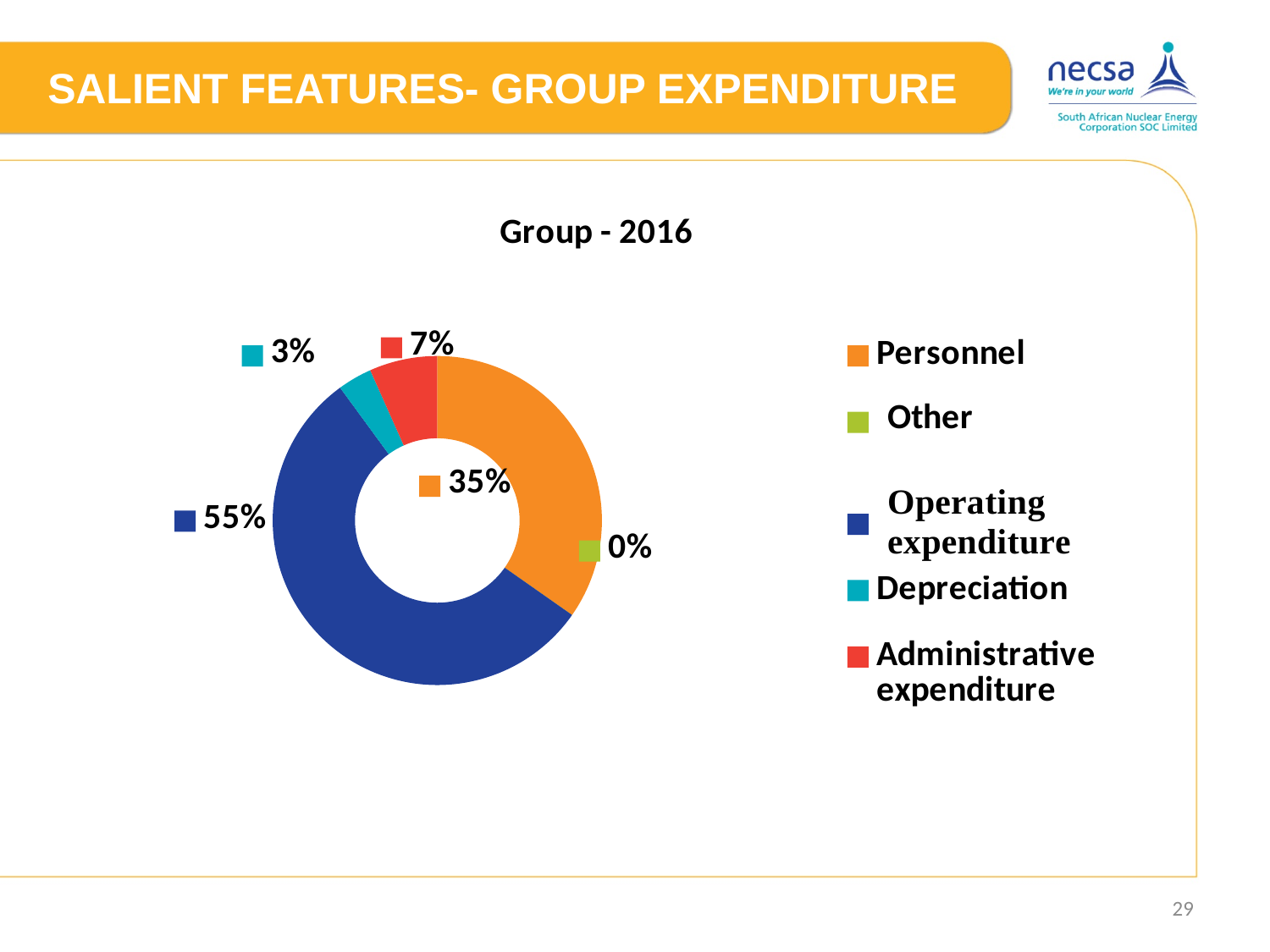
How many categories does the legend list? 5 What is the difference in percentage points between Operating expenditure and Personnel? 20 percentage points What share of Group expenditure in 2016 is Administrative expenditure? 7% Which is larger, the share for Administrative expenditure or the share for Depreciation? Administrative expenditure What share of Group expenditure in 2016 is Personnel? 35% Which category has the largest share of Group expenditure in 2016? Operating expenditure What is the title of the chart? Group - 2016 What kind of chart is shown on the slide? Pie (doughnut) chart What share of Group expenditure in 2016 is Depreciation? 3% Which category has the smallest share of Group expenditure in 2016? Other